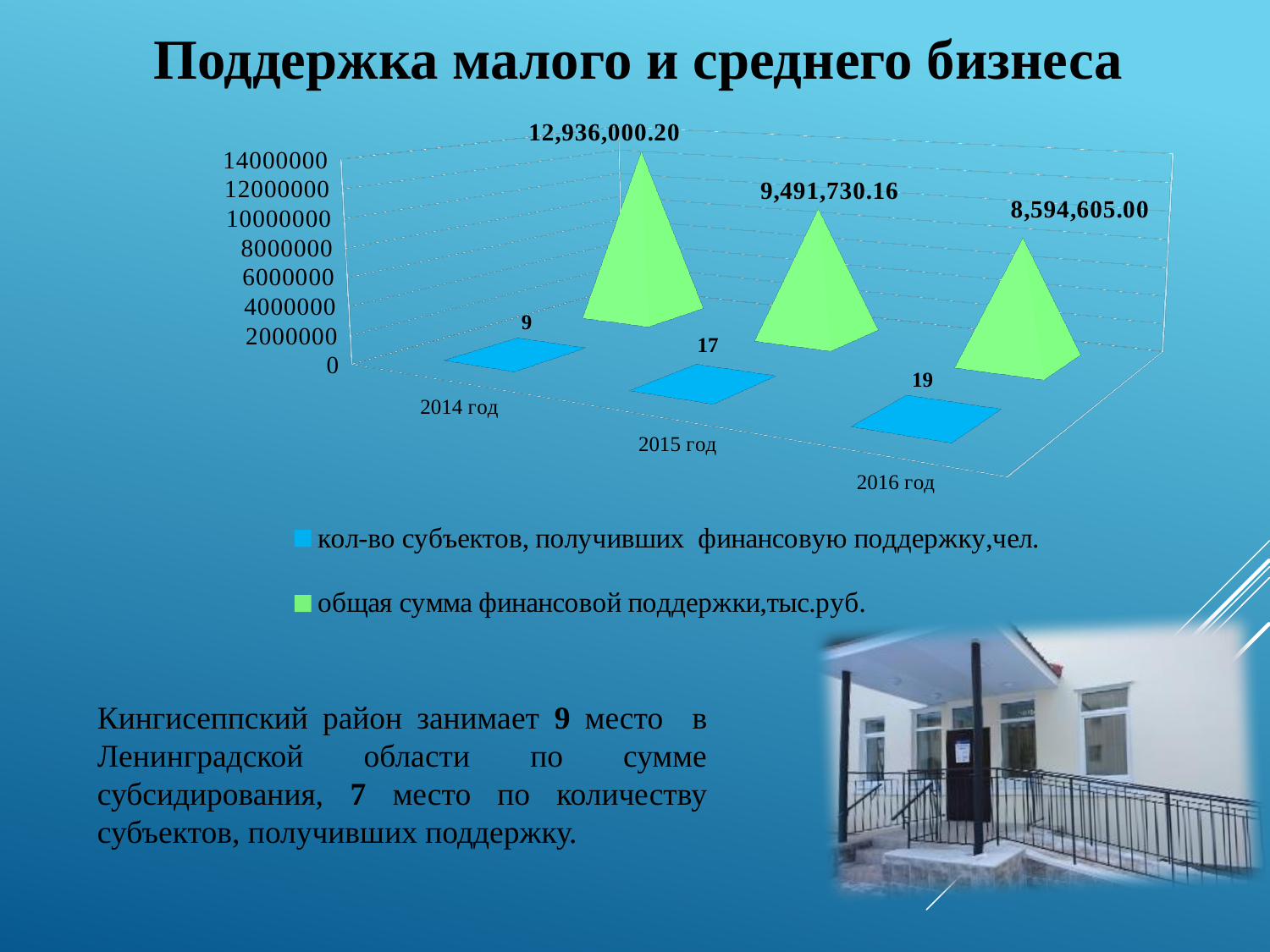
Which year had a larger total sum of financial support, 2015 год or 2016 год? 2015 год What is the total sum of financial support (общая сумма финансовой поддержки) for 2014 год? 12,936,000.20 What is the total sum of financial support for 2016 год? 8,594,605.00 By how many did the number of subjects receiving support increase from 2014 год to 2016 год? 10 How many series does the chart legend list? 2 In which year was the number of subjects receiving financial support the lowest? 2014 год How many years (categories) are shown on the chart? 3 What is the difference between the total sum of financial support in 2014 год and 2015 год? 3,444,270.04 How many subjects received financial support in 2016 год? 19 In which year was the total sum of financial support the highest? 2014 год How many subjects received financial support (кол-во субъектов) in 2015 год? 17 How does the total sum of financial support change from 2014 год to 2016 год? It falls